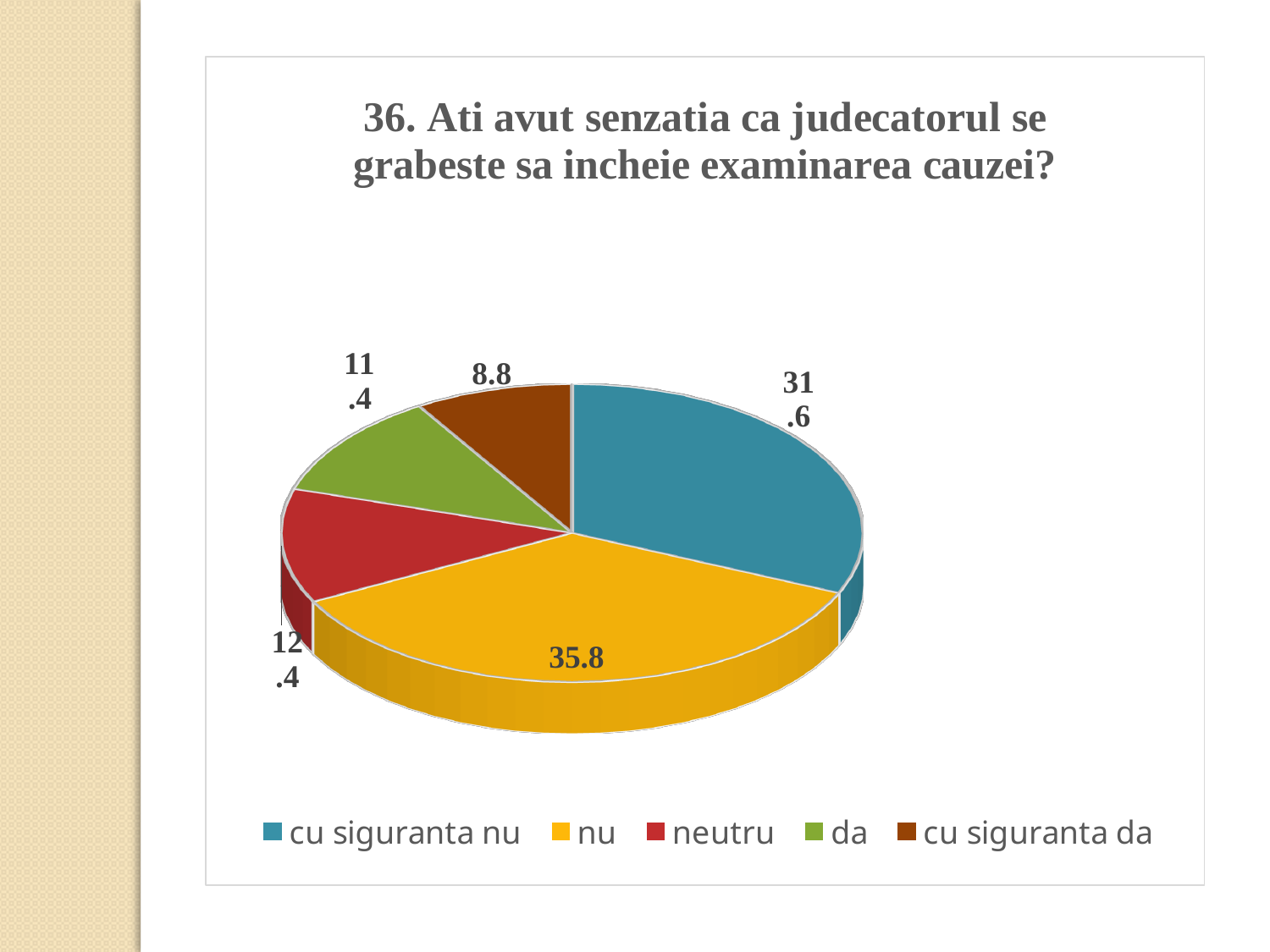
Which is larger, the value for "neutru" or the value for "da"? neutru What is the difference between the values for "nu" and "cu siguranta nu"? 4.2 Which category has the largest slice? nu What is the value for "neutru"? 12.4 What is the value for "cu siguranta da"? 8.8 What is the value for "cu siguranta nu"? 31.6 What colour is the slice for "cu siguranta nu"? blue What is the value for "nu"? 35.8 Which category has the smallest slice? cu siguranta da How many categories does the legend list? 5 What kind of chart is shown on the slide? pie chart What is the value for "da"? 11.4